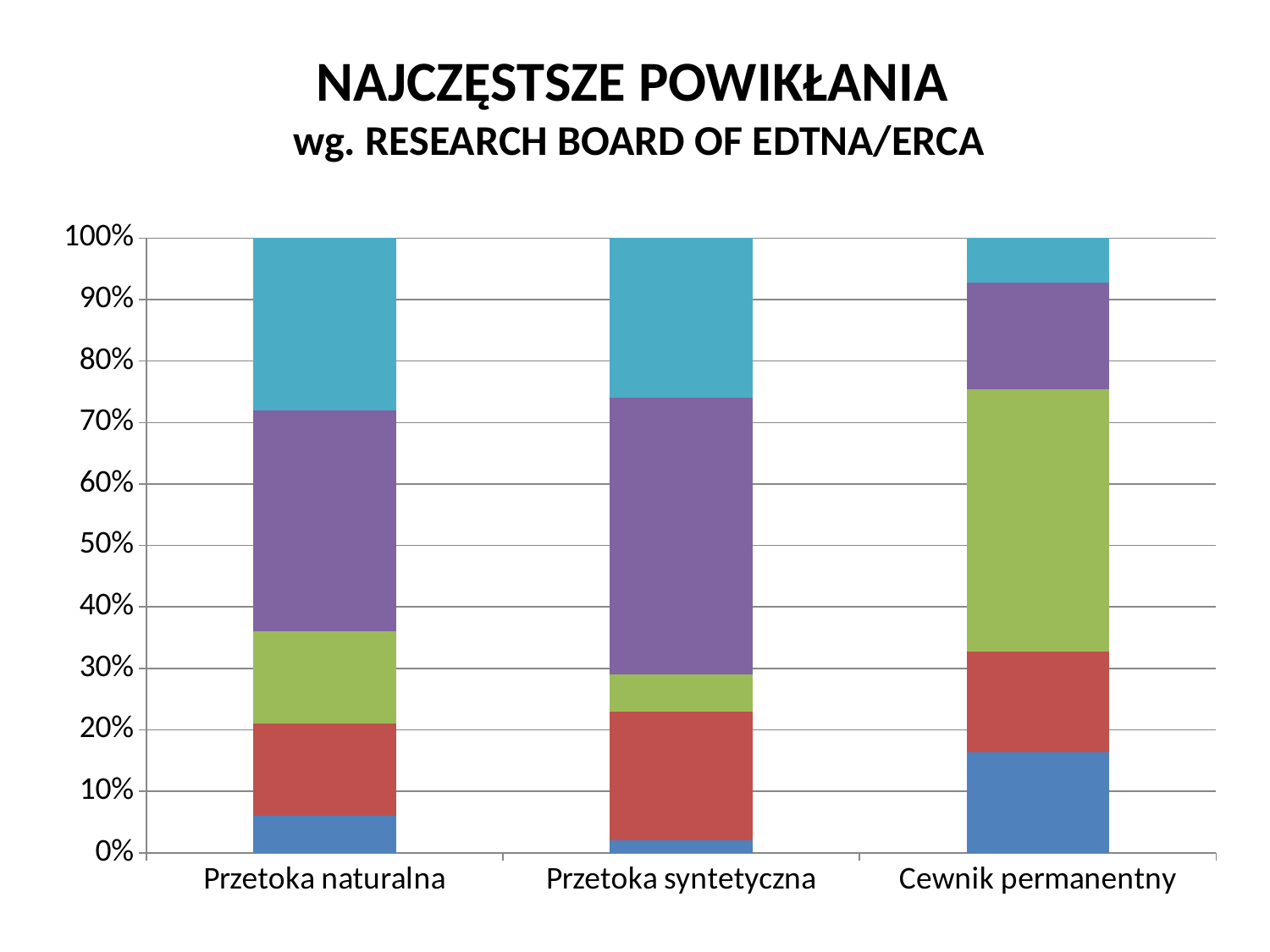
Which category has the smallest blue (bottom) segment? Przetoka syntetyczna How many categories are shown on the x axis of the chart? 3 Is the blue (bottom) segment for Cewnik permanentny greater or less than 10%? greater What is the title of the chart on the slide? NAJCZĘSTSZE POWIKŁANIA wg. RESEARCH BOARD OF EDTNA/ERCA What is the total height of the stacked bar for Cewnik permanentny? 100% What kind of chart is shown on the slide? Stacked bar chart Is the combined share of the blue and red segments for Przetoka syntetyczna greater or less than 20%? greater Which category has the larger purple segment, Przetoka syntetyczna or Cewnik permanentny? Przetoka syntetyczna What is the total height of the stacked bar for Przetoka naturalna? 100% Which category has the largest green segment? Cewnik permanentny Is the blue (bottom) segment for Przetoka naturalna greater or less than 10%? less Which category has the larger green segment, Przetoka naturalna or Przetoka syntetyczna? Przetoka naturalna